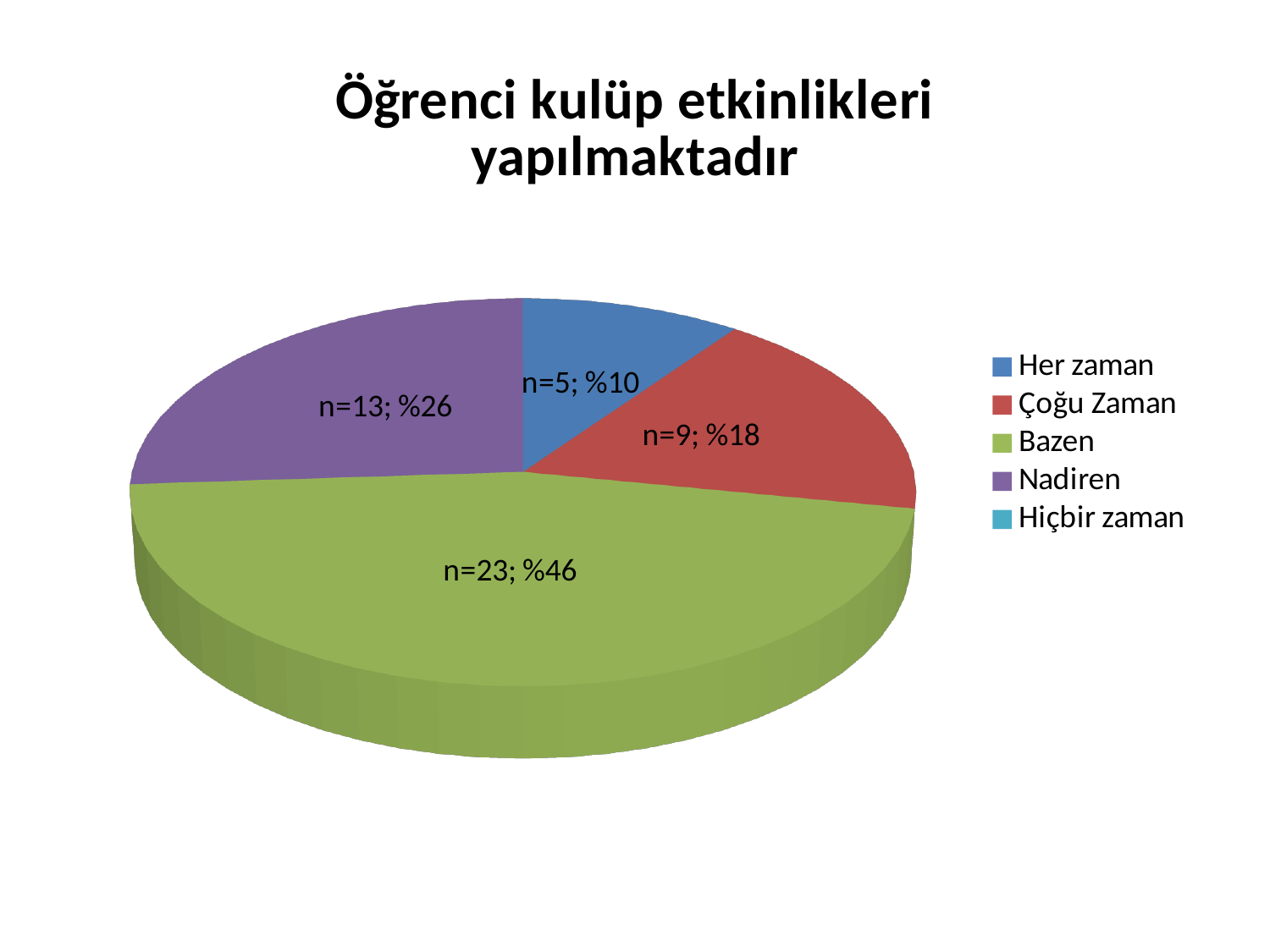
Among the slices with labels shown, which category has the smallest slice? Her zaman What percentage share does the Çoğu Zaman slice have? %18 How many entries does the legend list? 5 What is the count (n) for the Her zaman slice? n=5 What colour is the Bazen slice? green Which category has the largest slice? Bazen What percentage share does the Nadiren slice have? %26 What is the title of the chart? Öğrenci kulüp etkinlikleri yapılmaktadır Which is larger, the Çoğu Zaman slice or the Nadiren slice? Nadiren What is the count (n) for the Bazen slice? n=23 What kind of chart is shown on the slide? pie chart What is the difference in count (n) between Bazen and Nadiren? 10